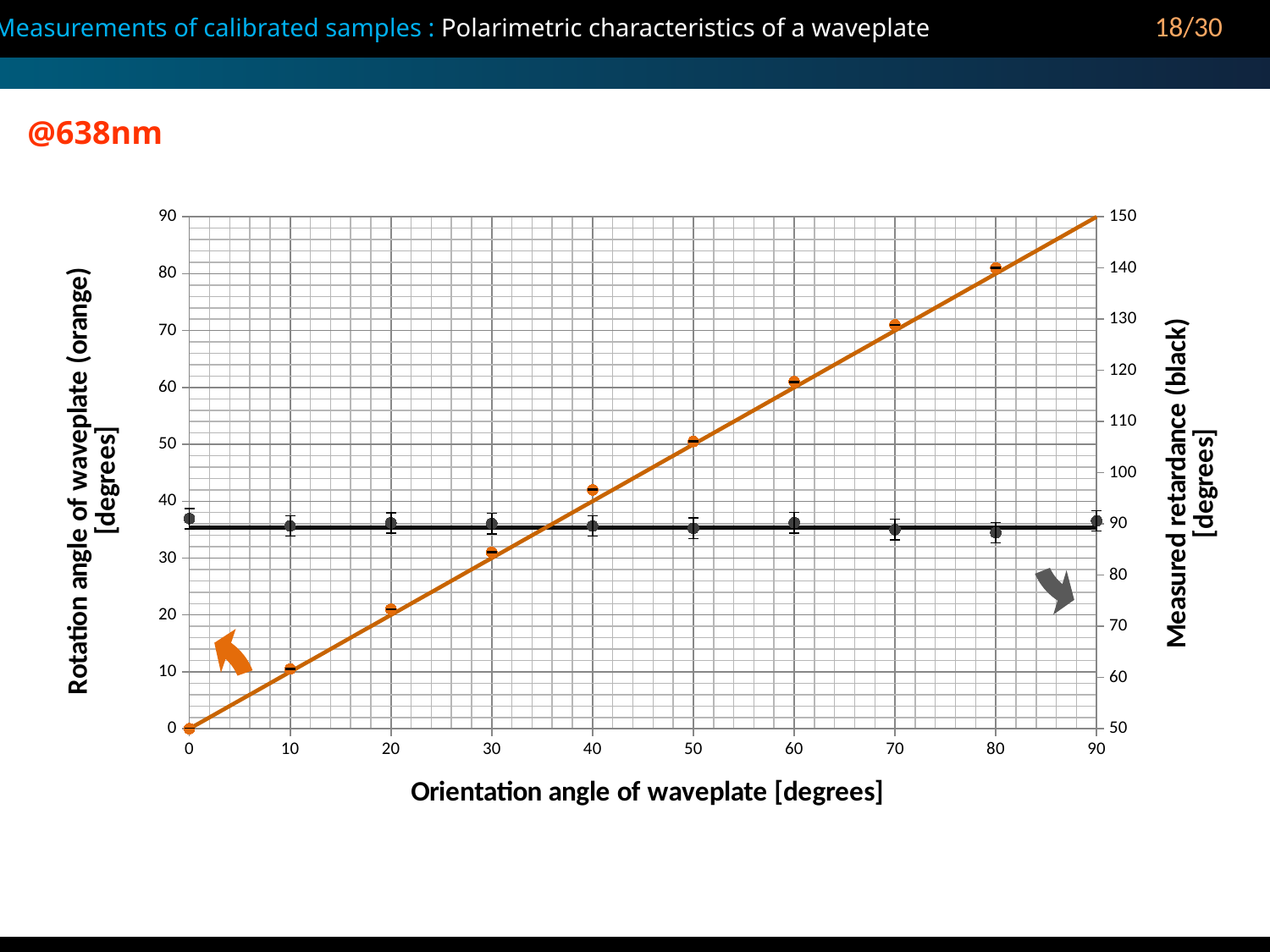
What is the rotation angle (orange) at an orientation angle of 0 degrees? 0 Is the measured retardance (black) at an orientation angle of 50 degrees greater or less than 100 on the right axis? less Does the black measured retardance series rise, fall, or stay roughly constant as the orientation angle increases? stay roughly constant Is the measured retardance (black) at an orientation angle of 30 degrees greater or less than 80 on the right axis? greater What is the title of the right-hand y axis? Measured retardance (black) [degrees] How many black measured retardance points are plotted? 10 Is the rotation angle (orange) at an orientation angle of 80 degrees greater or less than 70? greater Does the orange rotation angle series rise or fall as the orientation angle increases? rise What is the title of the x axis? Orientation angle of waveplate [degrees] What kind of chart is shown on the slide? scatter chart with lines Which orientation angle has the highest rotation angle (orange) among the plotted points? 80